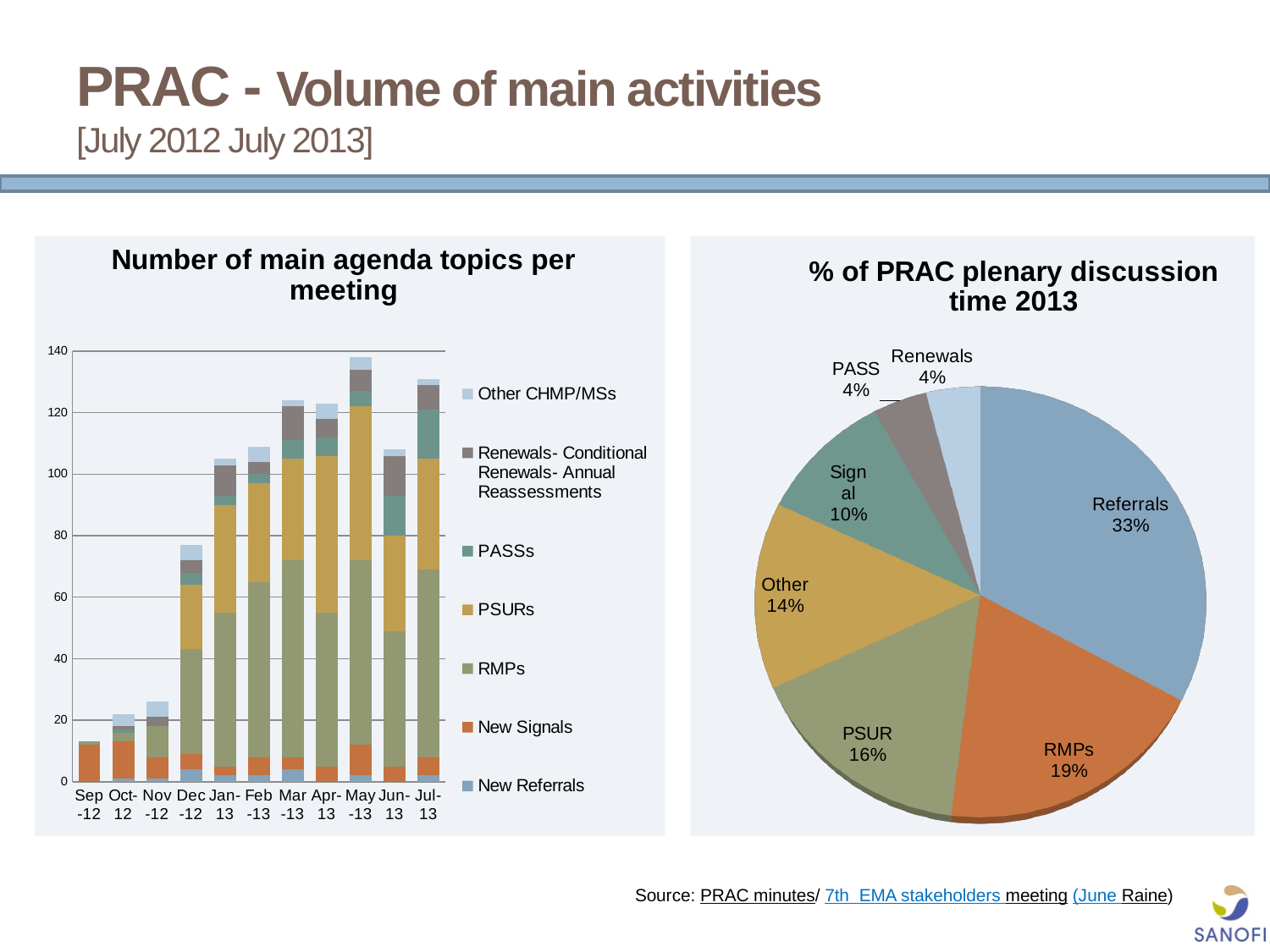
In the pie chart '% of PRAC plenary discussion time 2013', which is larger, PSUR or Other? PSUR In the chart 'Number of main agenda topics per meeting', which month has the lowest total number of topics? Sep-12 In the pie chart '% of PRAC plenary discussion time 2013', how many percentage points larger is Referrals than RMPs? 14% How many meetings (months) are shown on the x axis of the chart 'Number of main agenda topics per meeting'? 11 How many slices does the pie chart '% of PRAC plenary discussion time 2013' have? 7 In the pie chart '% of PRAC plenary discussion time 2013', what share of discussion time is taken by Referrals? 33% In the pie chart '% of PRAC plenary discussion time 2013', what percentage is shown for RMPs? 19% What kind of chart is 'Number of main agenda topics per meeting'? Stacked bar chart In the chart 'Number of main agenda topics per meeting', is the total for May-13 greater or less than 120? greater How many series does the legend of the chart 'Number of main agenda topics per meeting' list? 7 In the pie chart '% of PRAC plenary discussion time 2013', what percentage is shown for Signal? 10% In the pie chart '% of PRAC plenary discussion time 2013', which category has the largest share? Referrals